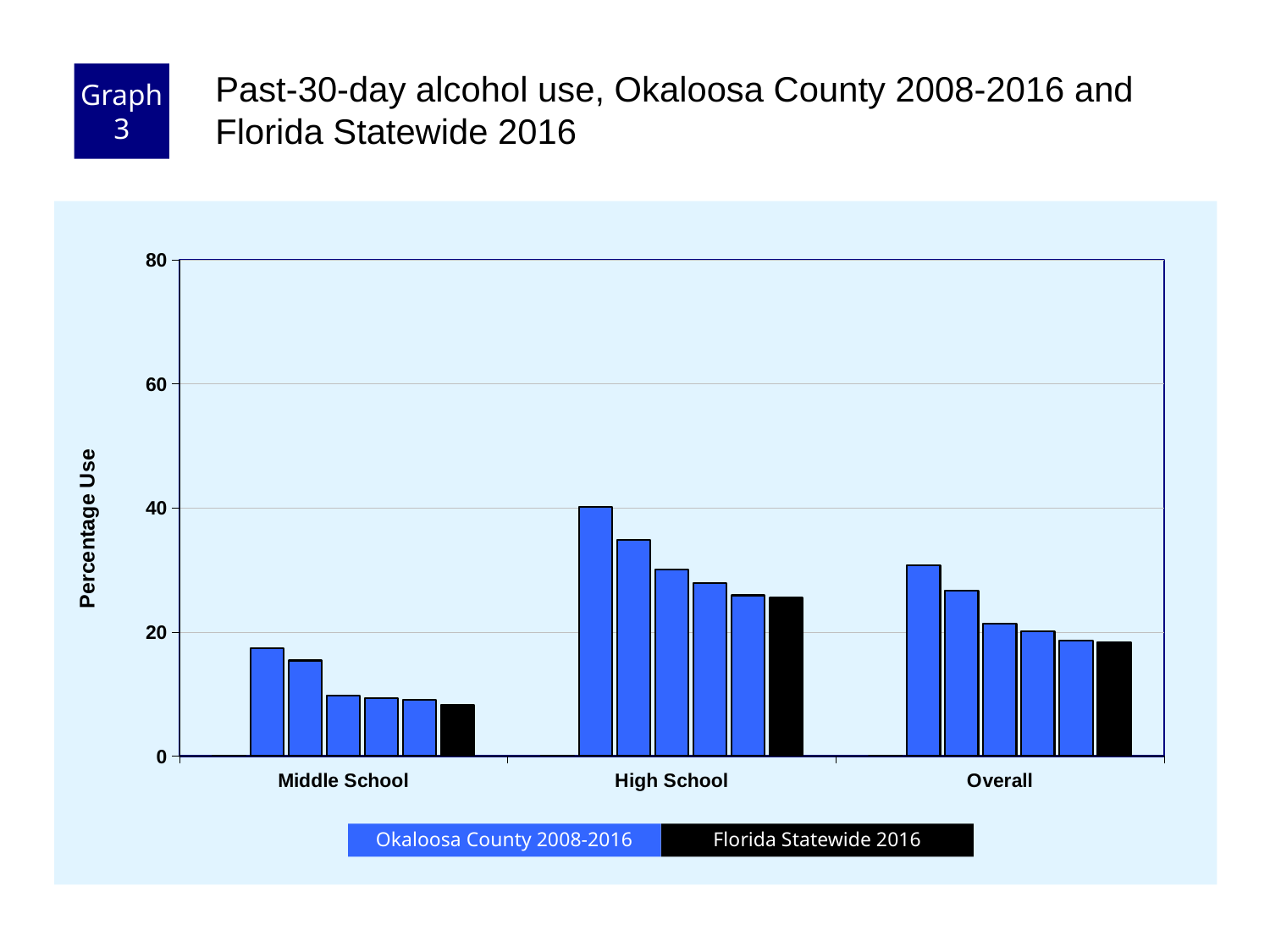
Is the tallest Okaloosa County bar for Overall greater or less than 20? greater Is the tallest Okaloosa County bar for Middle School greater or less than 20? less How many categories are shown along the x axis? 3 Is the Florida Statewide 2016 value for High School greater or less than 20? greater What is the label on the y axis? Percentage Use Which category has the highest bars? High School Which is larger, the Florida Statewide 2016 value for High School or for Overall? High School What kind of chart is shown on the slide? bar chart How many series does the legend list? 2 Which category has the lowest bars? Middle School Within the High School group, do the Okaloosa County bars rise or fall from 2008 to 2016? fall